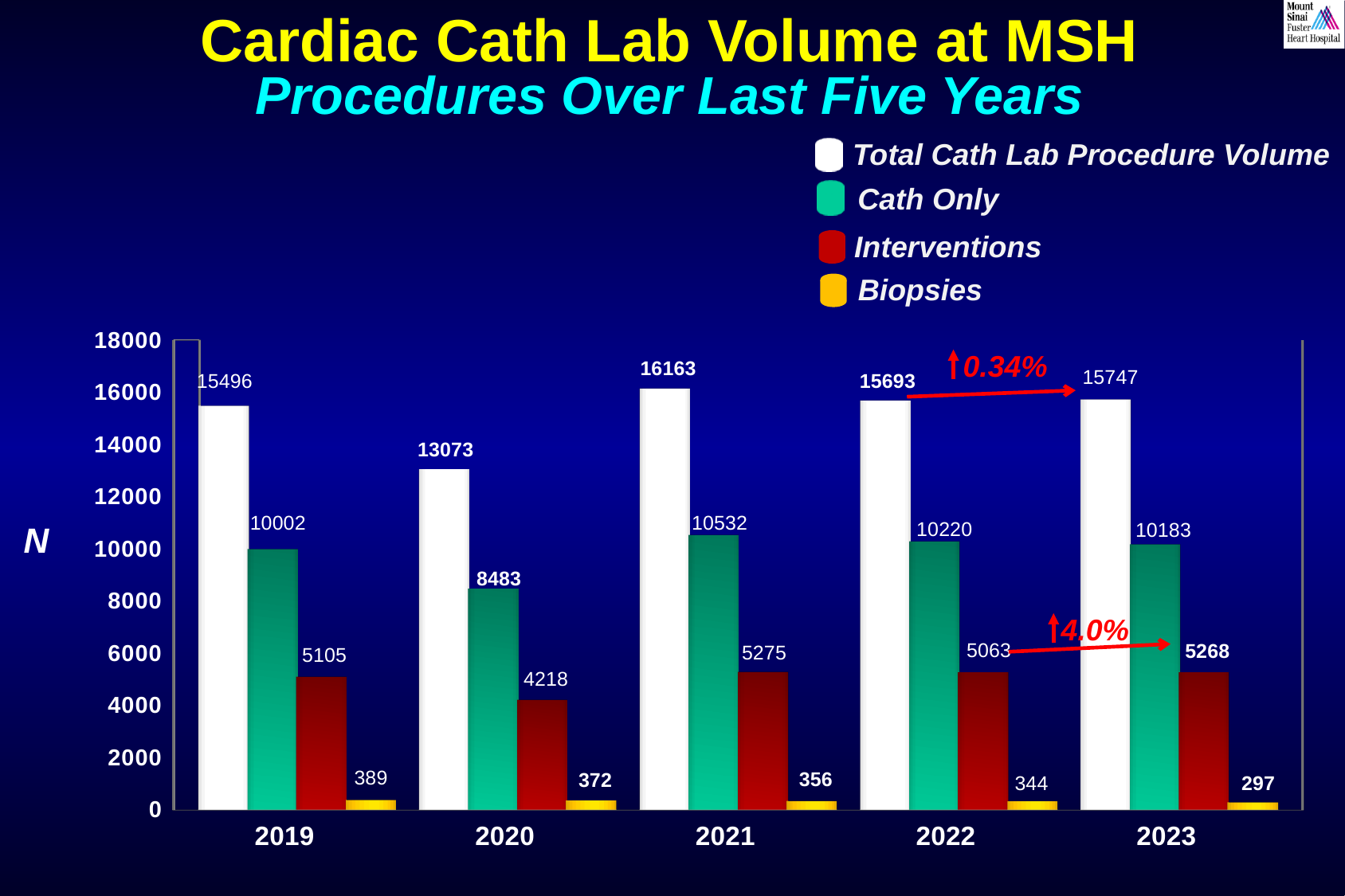
Do the Biopsies values rise or fall from 2019 to 2023? Fall What is the difference between the Total Cath Lab Procedure Volume in 2023 and in 2022? 54 What kind of chart is shown on the slide? Bar chart Which year had the lowest Cath Only value? 2020 How many years are shown on the x axis? 5 How many series does the legend list? 4 What was the Biopsies value in 2019? 389 Which is larger, the Interventions value in 2019 or in 2021? 2021 What was the Interventions value in 2023? 5268 What was the Total Cath Lab Procedure Volume in 2021? 16163 Which year had the highest Total Cath Lab Procedure Volume? 2021 What was the Cath Only value in 2020? 8483